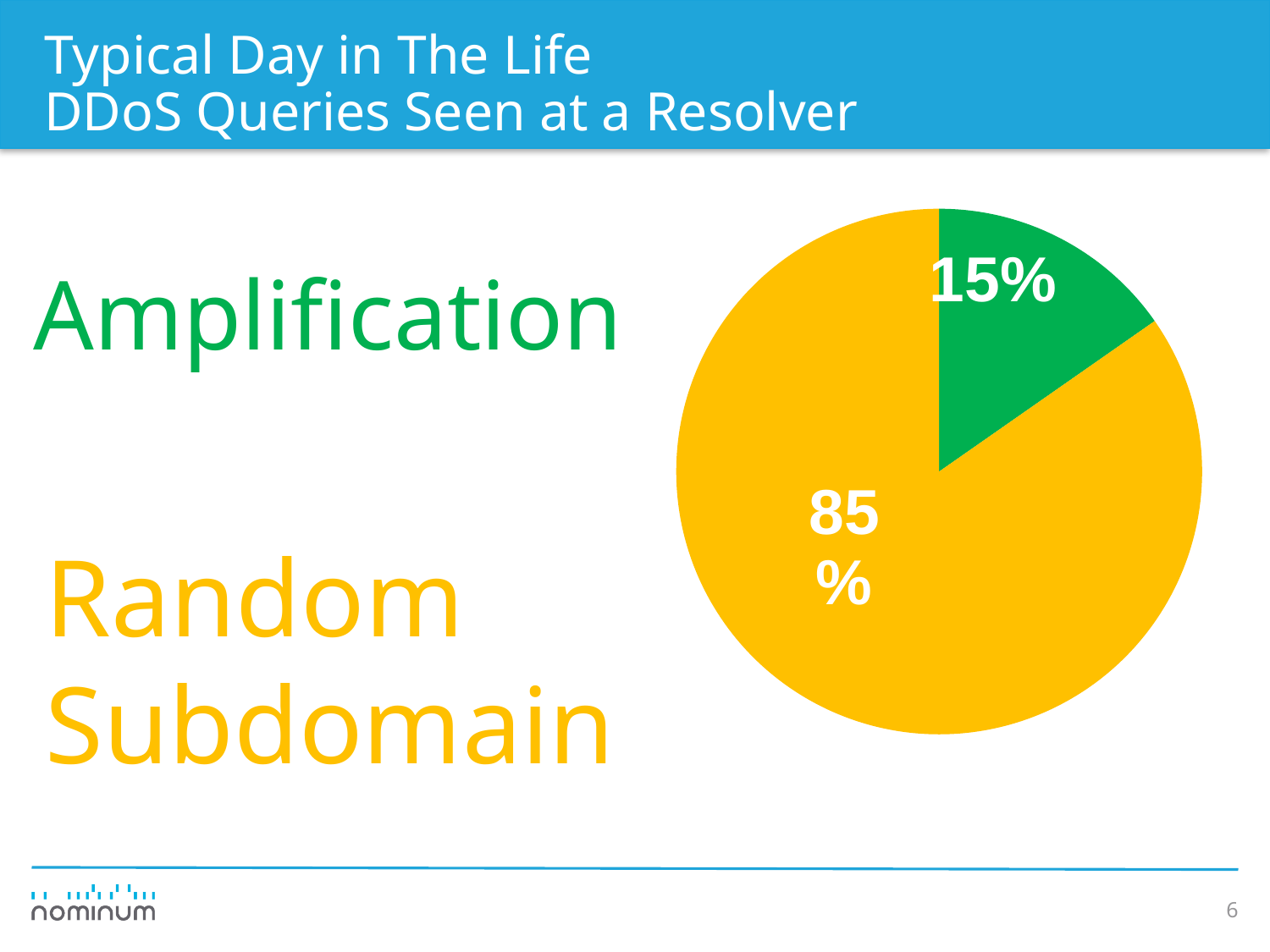
How many slices does the pie chart have? 2 What colour is the Random Subdomain slice? yellow Which is larger, the Amplification slice or the Random Subdomain slice? Random Subdomain Which category has the largest slice of the pie? Random Subdomain What is the total of the two slice percentages shown on the pie chart? 100% What is the difference in percentage points between the Random Subdomain and Amplification slices? 70 Which category has the smallest slice of the pie? Amplification What share of DDoS queries is attributed to Amplification? 15% What share of DDoS queries is attributed to Random Subdomain? 85% What kind of chart is shown on the slide? pie chart What colour is the Amplification slice? green